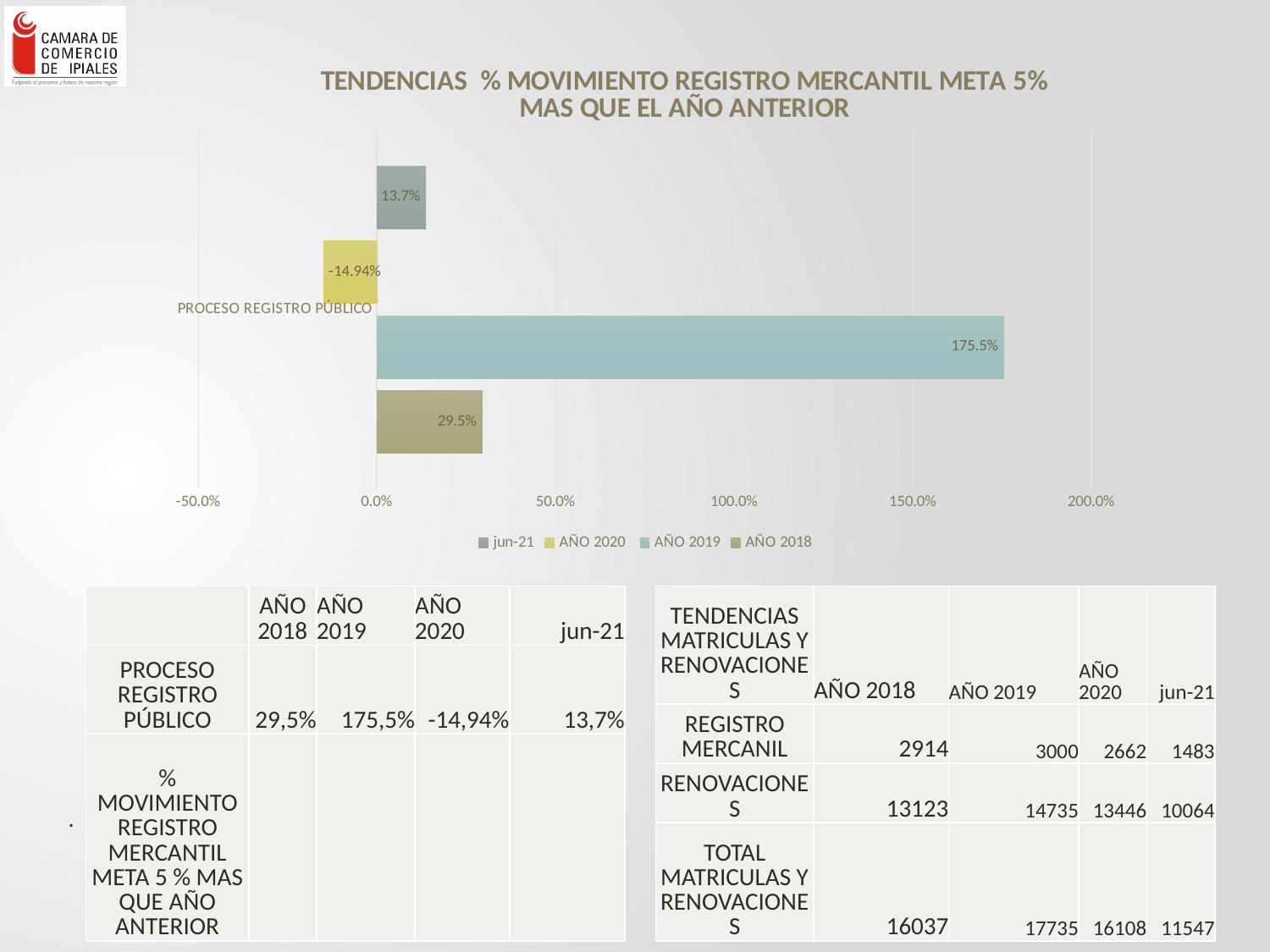
Which series has the highest value in the chart? AÑO 2019 How many series does the legend list? 4 Which is larger, the value for AÑO 2018 or the value for jun-21? AÑO 2018 What is the value for AÑO 2019 in the chart? 175.5% What type of chart is shown on the slide? bar chart What is the value for AÑO 2018 in the chart? 29.5% What is the difference between the values for AÑO 2019 and AÑO 2018? 146 percentage points Is the value for AÑO 2019 greater or less than 150.0%? greater What is the value for jun-21 in the chart? 13.7% Which series has the lowest value in the chart? AÑO 2020 What category label is shown on the vertical axis of the chart? PROCESO REGISTRO PÚBLICO What is the value for AÑO 2020 in the chart? -14.94%